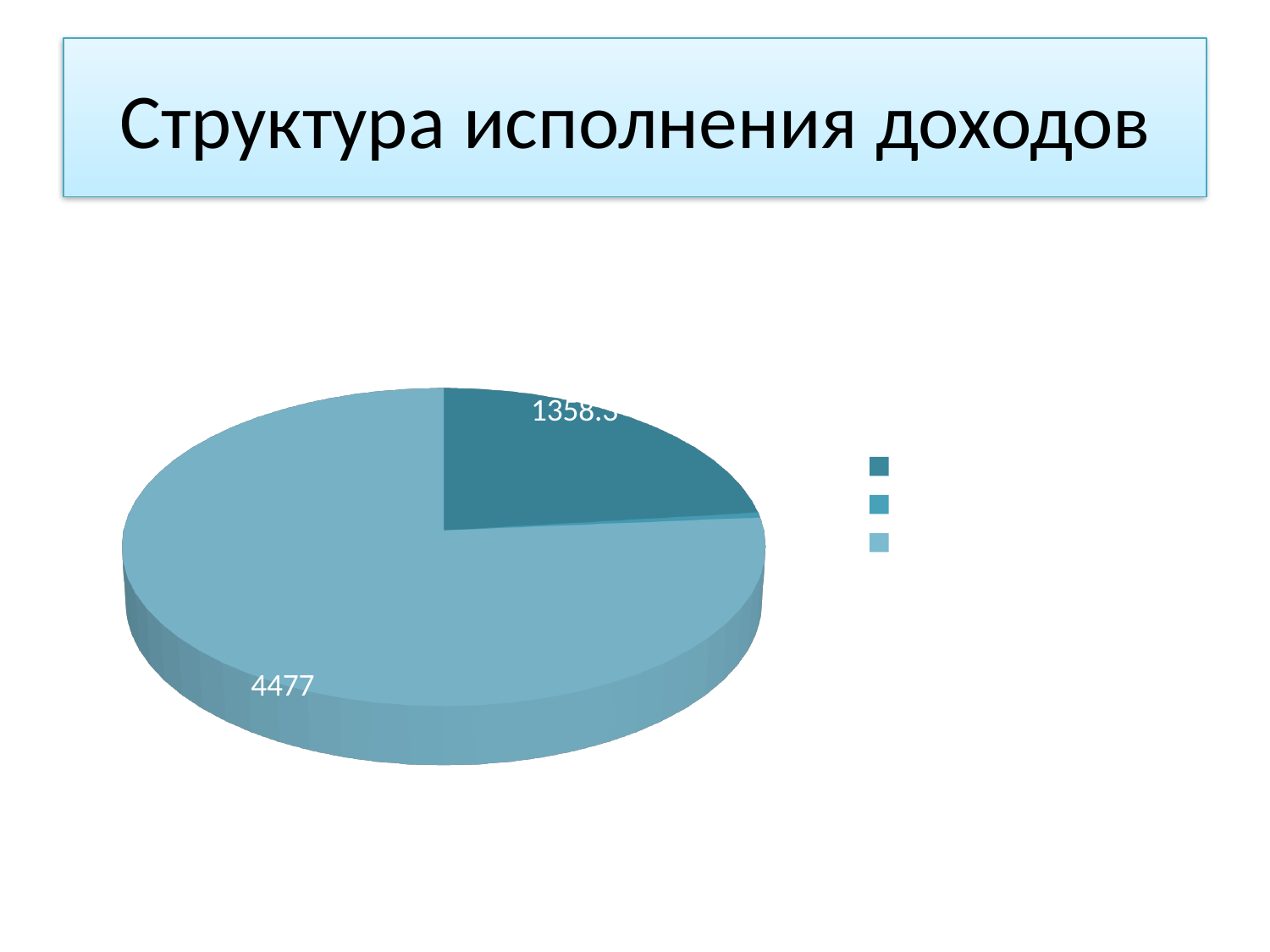
Is the dark teal slice of the pie chart larger or smaller than the light blue slice? smaller What colour is the largest slice of the pie chart? light blue Which slice of the pie chart is larger: the one labelled 4477 or the one labelled 1358.3? 4477 What is the title of the chart on the slide? Структура исполнения доходов What kind of chart is shown on the slide? pie chart How many entries does the legend of the pie chart list? 3 What is the value printed on the largest slice of the pie chart? 4477